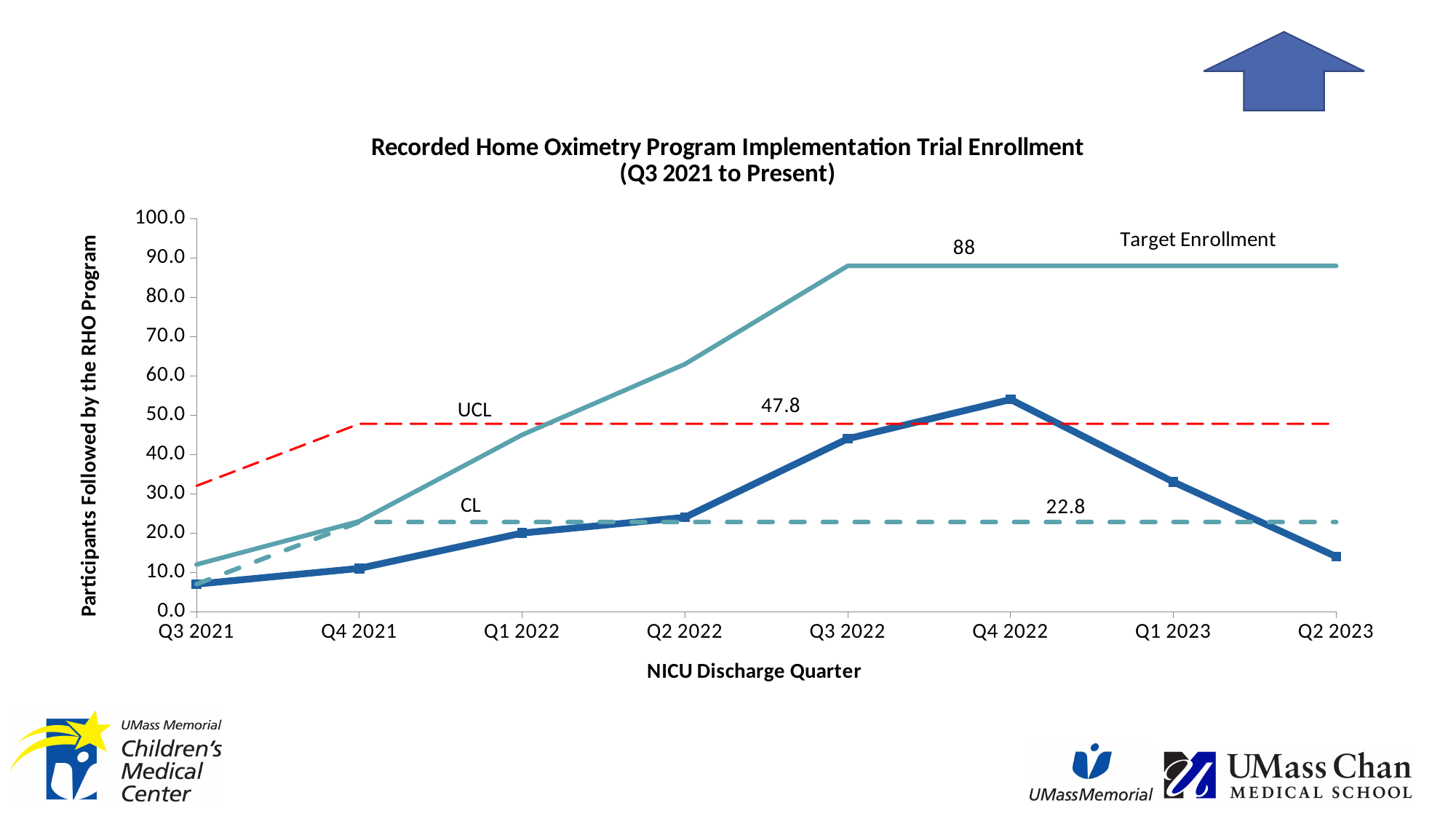
What kind of chart is shown on the slide? line chart Is the value of the dark blue participants line for Q4 2022 greater or less than 50? greater In which quarter does the dark blue participants line have its lowest value? Q3 2021 How many NICU discharge quarters are shown on the x axis? 8 What is the Target Enrollment value labeled on the chart? 88 In which quarter does the dark blue participants line reach its highest value? Q4 2022 Is the value of the dark blue participants line for Q2 2023 greater or less than 20? less What is the CL value labeled on the chart? 22.8 Does the dark blue participants line rise or fall from Q4 2022 to Q2 2023? fall What is the difference between the UCL value and the CL value? 25.0 Which quarter has a higher value on the dark blue participants line, Q3 2022 or Q1 2023? Q3 2022 What is the UCL value labeled on the chart? 47.8